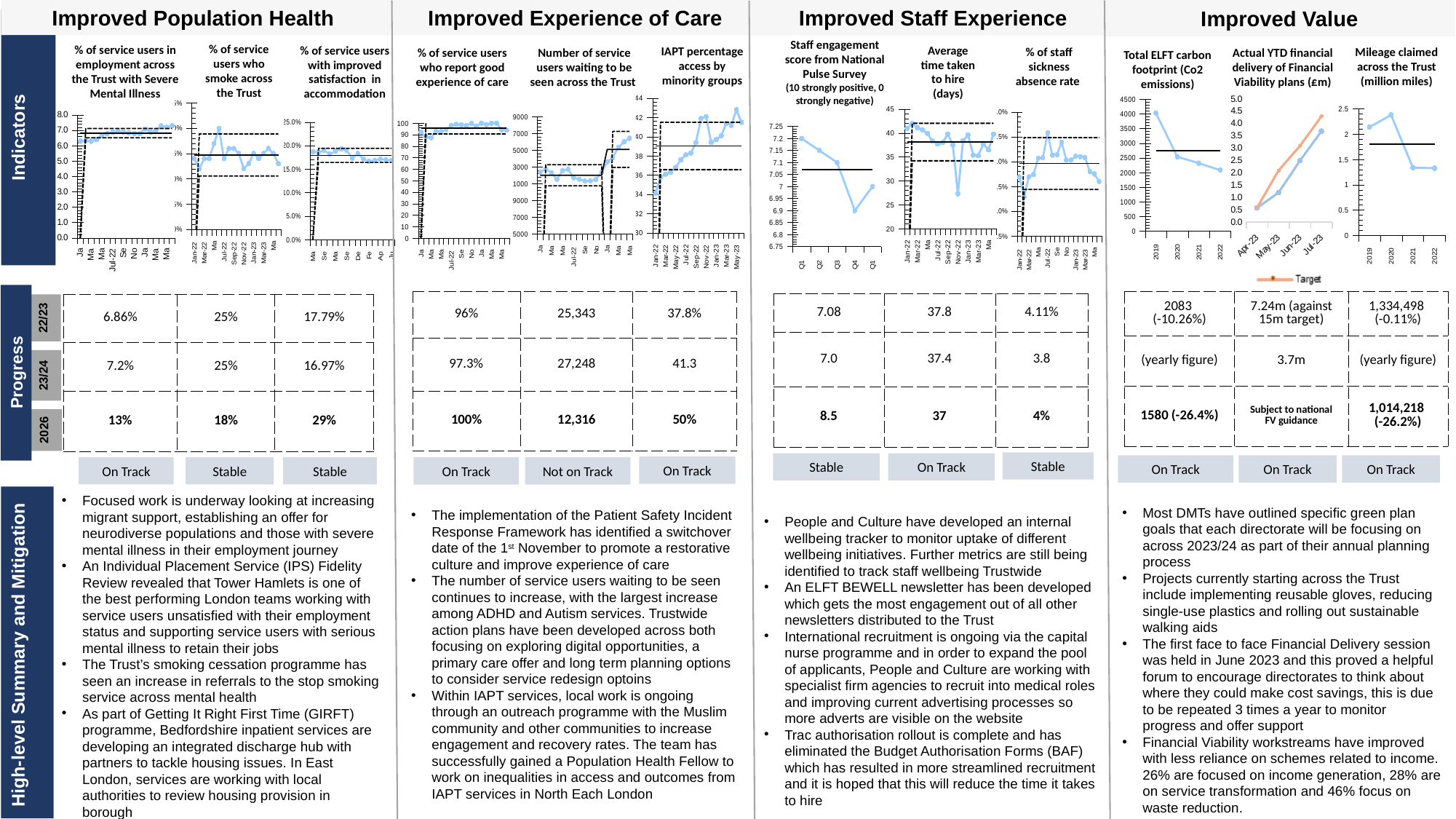
In the 'Mileage claimed across the Trust (million miles)' chart, is the value for 2020 greater or less than 2? greater In the 'Total ELFT carbon footprint (Co2 emissions)' chart, how many years are plotted on the x axis? 4 In the 'Total ELFT carbon footprint (Co2 emissions)' chart, do the values rise or fall from 2019 to 2022? fall What kind of chart is the 'Total ELFT carbon footprint (Co2 emissions)' chart? line chart In the 'Total ELFT carbon footprint (Co2 emissions)' chart, which year has the highest value? 2019 In the 'Staff engagement score from National Pulse Survey' chart, which quarter has the lowest score? Q4 In the 'Staff engagement score from National Pulse Survey' chart, is the value for Q4 greater or less than 7? less In the 'IAPT percentage access by minority groups' chart, do the values generally rise or fall from Jan-22 to May-23? rise In the 'Actual YTD financial delivery of Financial Viability plans (£m)' chart, which series is named in the legend? Target In the 'Actual YTD financial delivery of Financial Viability plans (£m)' chart, at Jul-23 which is higher, the Target line or the actual line? Target In the 'Mileage claimed across the Trust (million miles)' chart, is the value for 2021 greater or less than 1.5? less